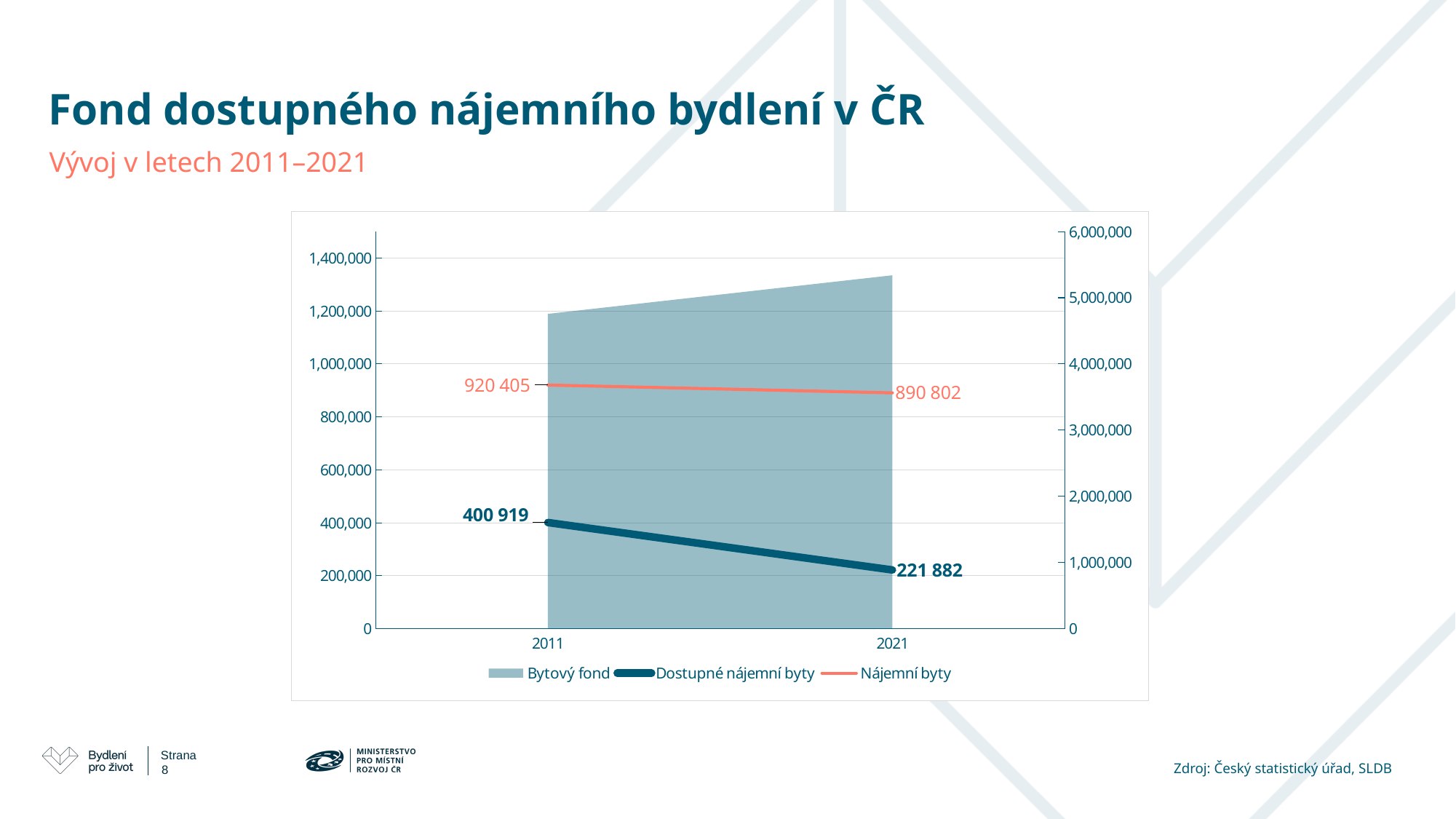
What is the value for Dostupné nájemní byty in 2021? 221 882 What is the value for Nájemní byty in 2011? 920 405 How many series does the legend list? 3 Does the Bytový fond area rise or fall from 2011 to 2021? rise Does the Dostupné nájemní byty series rise or fall from 2011 to 2021? fall By how much did Dostupné nájemní byty decrease between 2011 and 2021? 179 037 What is the value for Dostupné nájemní byty in 2011? 400 919 Which is larger in 2021: Nájemní byty or Dostupné nájemní byty? Nájemní byty On the right-hand axis, is the value for Bytový fond in 2021 greater or less than 5,000,000? greater Which years are shown on the x axis? 2011 and 2021 What is the difference between the Nájemní byty values for 2011 and 2021? 29 603 What is the value for Nájemní byty in 2021? 890 802